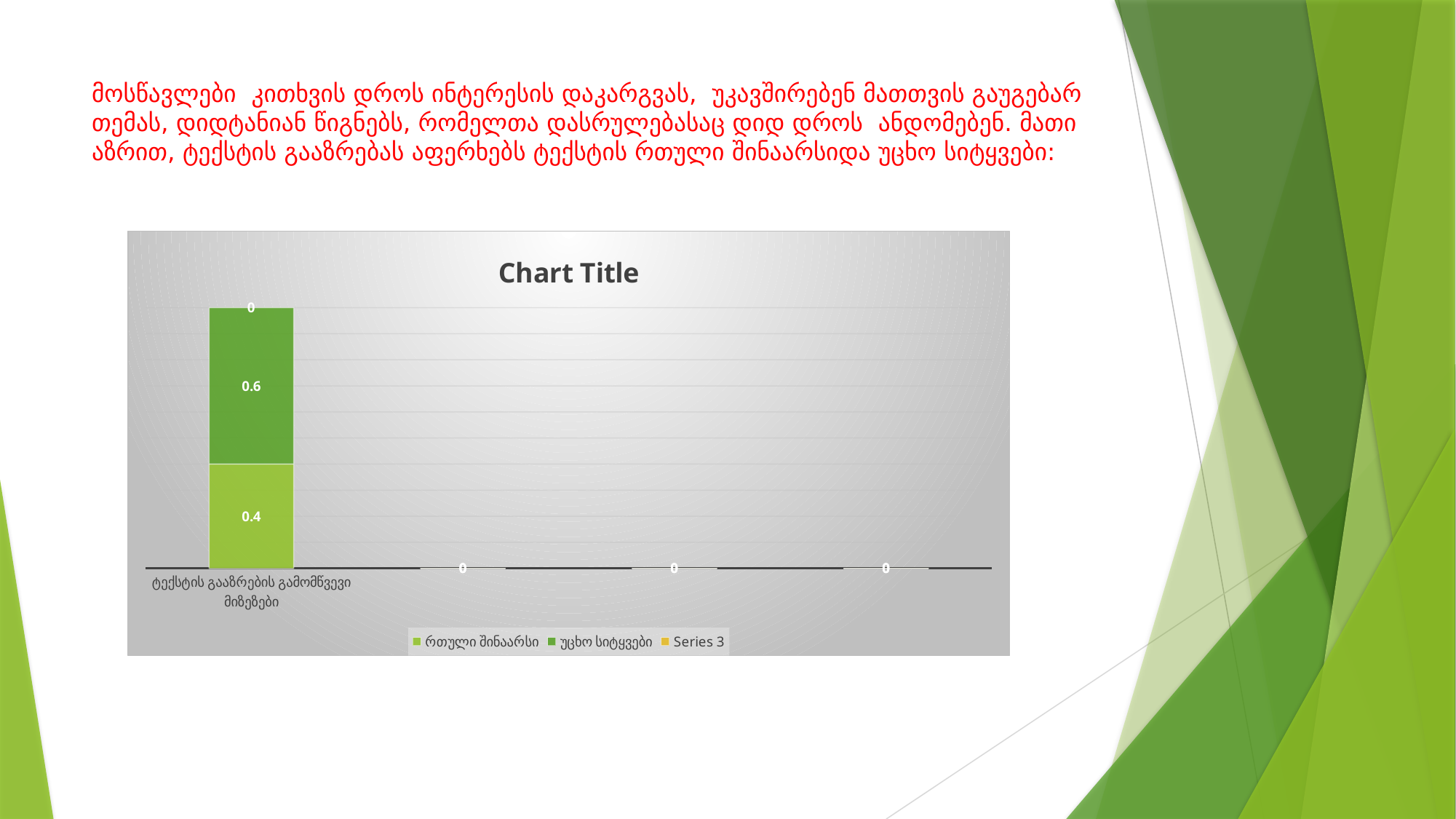
Which series is the smallest segment of the stacked bar for ტექსტის გააზრების გამომწვევი მიზეზები? Series 3 What is the value of Series 3 for the category ტექსტის გააზრების გამომწვევი მიზეზები? 0 What is the title of the chart? Chart Title What kind of chart is shown on the slide? stacked bar chart What is the total of the stacked bar for ტექსტის გააზრების გამომწვევი მიზეზები? 1 What is the value of the რთული შინაარსი series for the category ტექსტის გააზრების გამომწვევი მიზეზები? 0.4 How many series does the chart legend list? 3 Which series has the larger value for ტექსტის გააზრების გამომწვევი მიზეზები, რთული შინაარსი or უცხო სიტყვები? უცხო სიტყვები What is the value of the უცხო სიტყვები series for the category ტექსტის გააზრების გამომწვევი მიზეზები? 0.6 What is the name of the third series in the legend? Series 3 Which series is the largest segment of the stacked bar for ტექსტის გააზრების გამომწვევი მიზეზები? უცხო სიტყვები What is the difference between the უცხო სიტყვები value and the რთული შინაარსი value for ტექსტის გააზრების გამომწვევი მიზეზები? 0.2